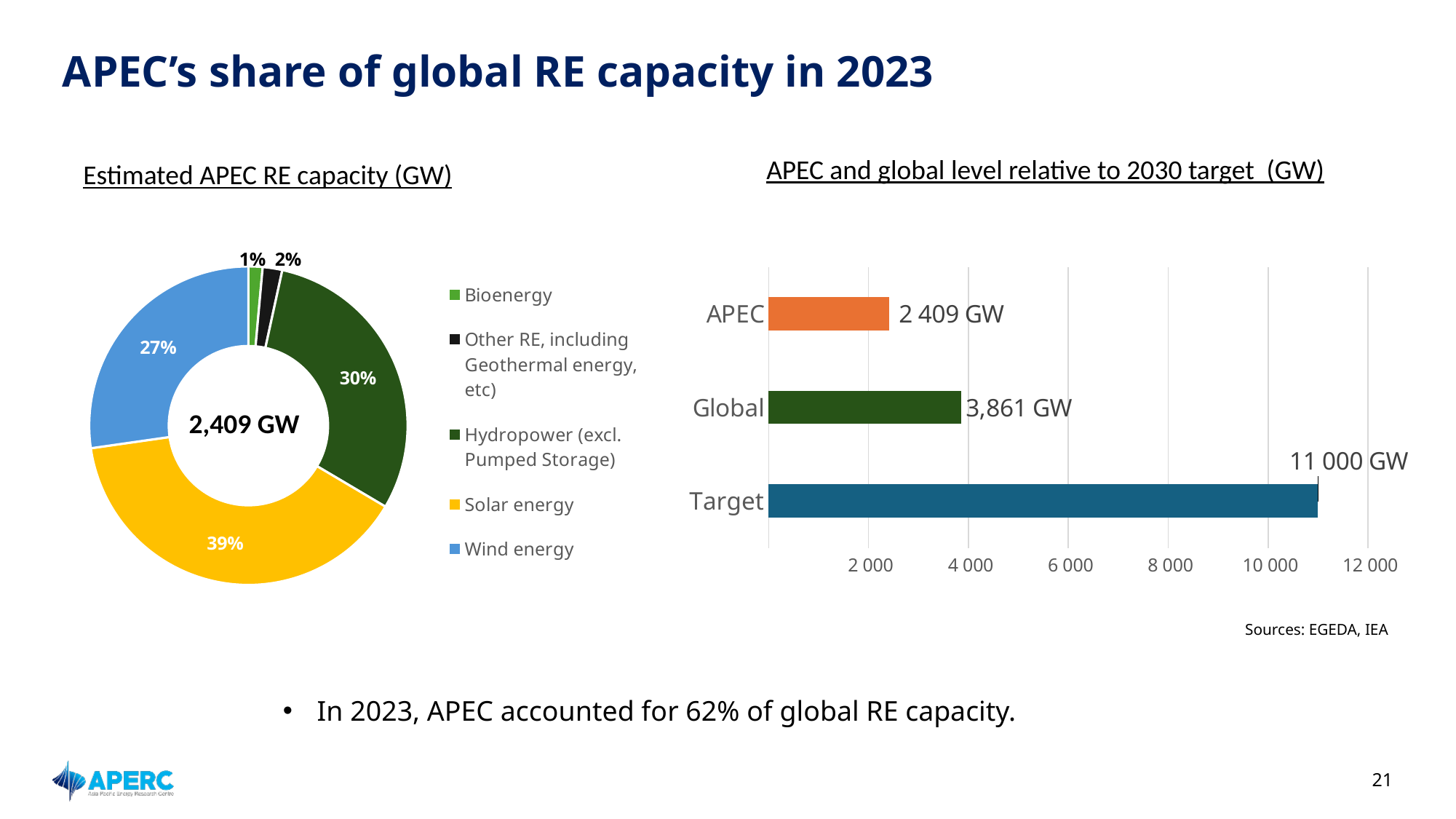
In the 'APEC and global level relative to 2030 target (GW)' chart, what is the value for Global? 3,861 GW In the 'Estimated APEC RE capacity (GW)' chart, what is the difference in percentage points between Solar energy and Hydropower (excl. Pumped Storage)? 9 In the 'Estimated APEC RE capacity (GW)' chart, which source has the largest share? Solar energy In the 'Estimated APEC RE capacity (GW)' chart, what total capacity is shown in the centre of the donut? 2,409 GW In the 'Estimated APEC RE capacity (GW)' chart, what share does Wind energy have? 27% In the 'APEC and global level relative to 2030 target (GW)' chart, which is larger, APEC or Global? Global In the 'Estimated APEC RE capacity (GW)' chart, how many sources does the legend list? 5 In the 'Estimated APEC RE capacity (GW)' chart, what share does Solar energy have? 39% In the 'APEC and global level relative to 2030 target (GW)' chart, what is the value for Target? 11 000 GW In the 'APEC and global level relative to 2030 target (GW)' chart, what kind of chart is used? Bar chart In the 'Estimated APEC RE capacity (GW)' chart, which source has the smallest share? Bioenergy In the 'APEC and global level relative to 2030 target (GW)' chart, how many bars are shown? 3